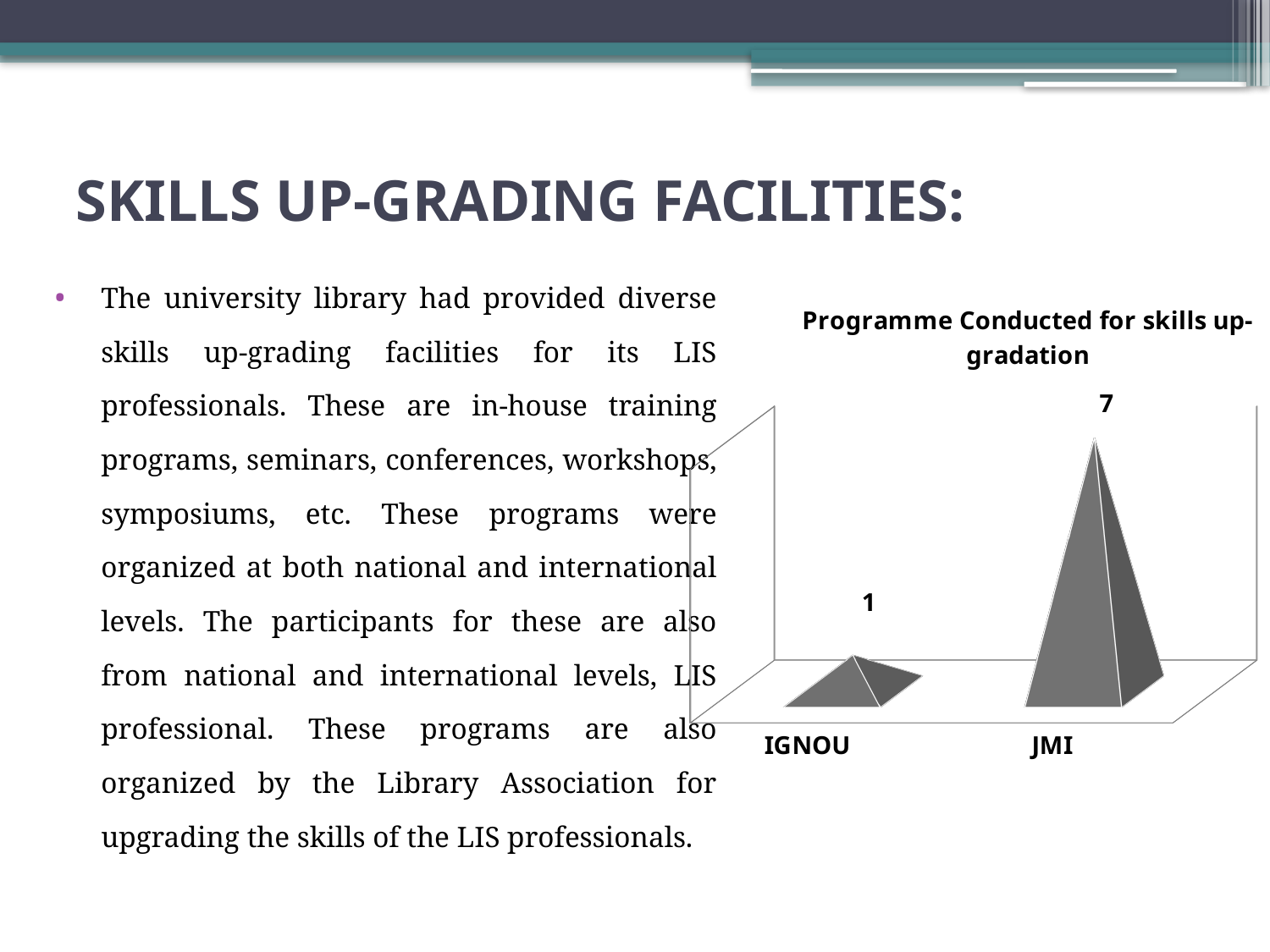
Do the values rise or fall from IGNOU to JMI? Rise What is the value for JMI in the chart? 7 What is the value for IGNOU in the chart? 1 What is the title of the chart? Programme Conducted for skills up-gradation How many categories are shown in the chart? 2 Which category has the lowest value in the chart? IGNOU What is the difference between the values for JMI and IGNOU? 6 Which category has the highest value in the chart? JMI What kind of chart is shown on the slide? Bar chart What is the total of the values for IGNOU and JMI? 8 Which has a larger value, IGNOU or JMI? JMI